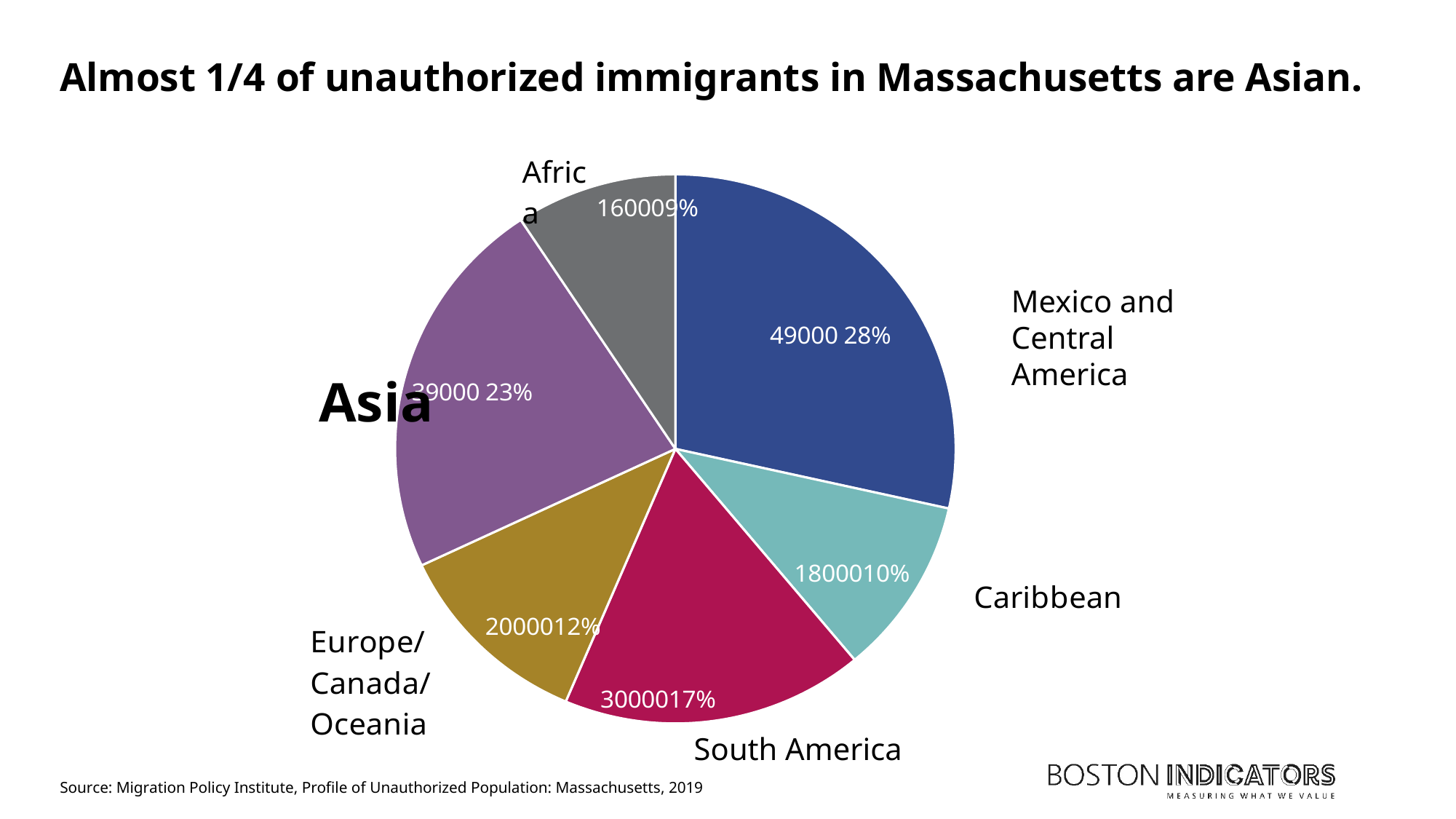
Which is larger, the slice for South America or the slice for Caribbean? South America What percentage of the pie does Asia represent? 23% Which region has the smallest slice of the pie? Africa What is the difference in percentage points between the Mexico and Central America slice and the Asia slice? 5 percentage points What percentage of the pie does Caribbean represent? 10% What is the value shown for South America? 30000 How many slices does the pie chart have? 6 What percentage of the pie does South America represent? 17% What is the value shown for Mexico and Central America? 49000 Which region has the largest slice of the pie? Mexico and Central America What kind of chart is shown on the slide? pie chart